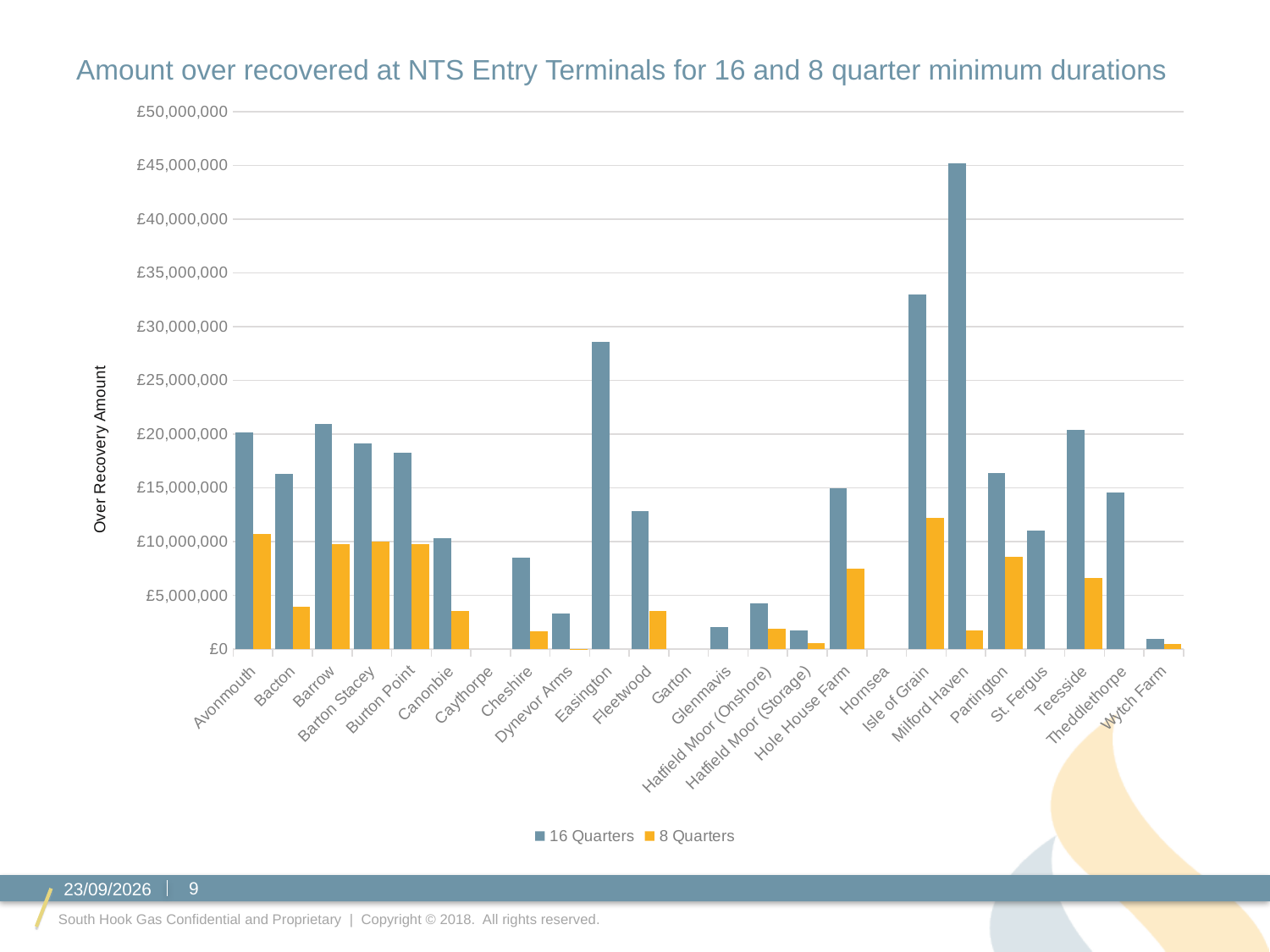
Is the 16 Quarters value for Easington greater or less than £25,000,000? greater Which has the larger 16 Quarters value, Barrow or Bacton? Barrow Which terminal has the highest 16 Quarters over recovery amount? Milford Haven What is the title of the chart? Amount over recovered at NTS Entry Terminals for 16 and 8 quarter minimum durations Is the 16 Quarters value for Milford Haven greater or less than £40,000,000? greater Is the 16 Quarters value for Fleetwood greater or less than £15,000,000? less Which terminal has the highest 8 Quarters over recovery amount? Isle of Grain What kind of chart is shown on the slide? Bar chart Which has the larger 16 Quarters value, Easington or Isle of Grain? Isle of Grain How many entry terminals are listed along the x axis? 24 How many series does the legend list? 2